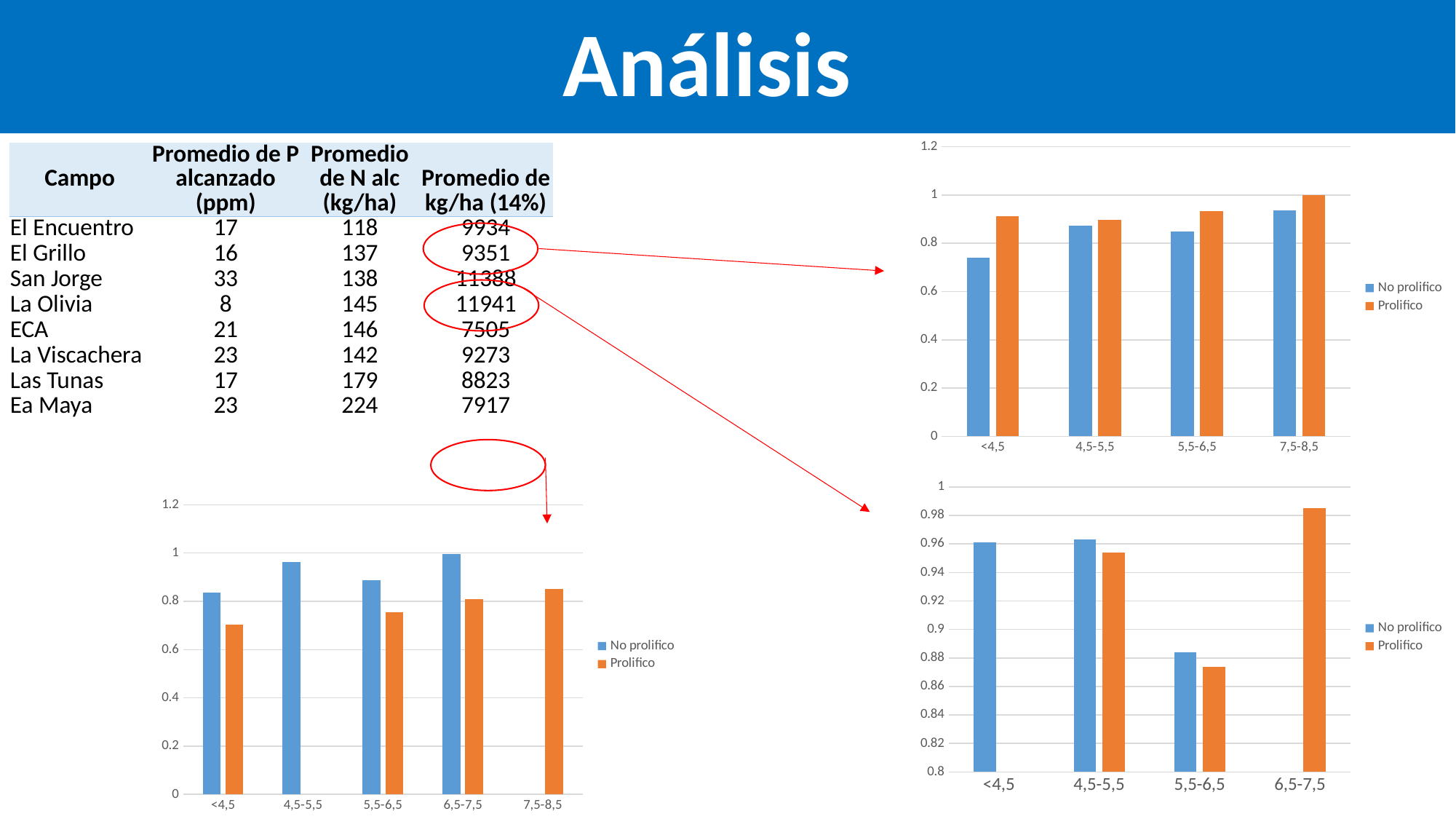
In the top-right chart, how many categories are shown on the x axis? 4 In the bottom-left chart, which category has the lowest Prolifico value? <4,5 In the bottom-left chart, for the category 5,5-6,5, which is larger: No prolifico or Prolifico? No prolifico In the top-right chart, is the Prolifico value for <4,5 greater or less than 0.8? greater What kind of chart is the chart in the top right of the slide? bar chart In the bottom-left chart, how many categories are shown on the x axis? 5 In the bottom-right chart, is the No prolifico value for 5,5-6,5 greater or less than 0.9? less In the top-right chart, is the No prolifico value for <4,5 greater or less than 0.8? less In the top-right chart, how many series does the legend list? 2 In the top-right chart, which category has the highest Prolifico value? 7,5-8,5 In the bottom-right chart, which category has the highest Prolifico value? 6,5-7,5